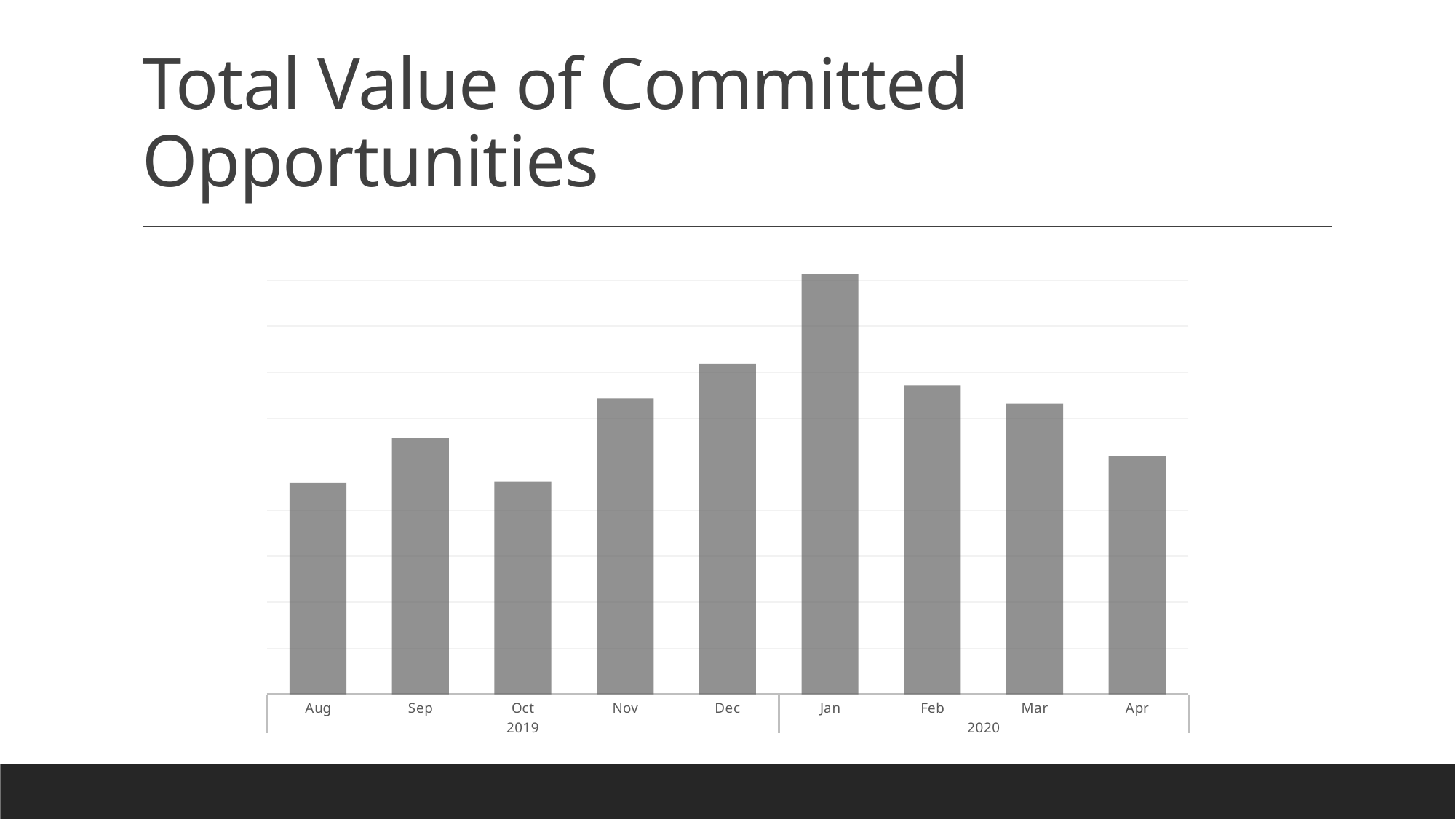
Which is larger, the value for Feb or the value for Apr? Feb Which is larger, the value for Dec or the value for Mar? Dec What kind of chart is shown on the slide? Bar chart Which is larger, the value for Nov or the value for Sep? Nov Which two years are labelled on the x axis of the chart? 2019 and 2020 Which month has the highest bar in the chart? Jan From Jan to Apr, do the values rise or fall? Fall How many bars (months) are plotted in the chart? 9 How many months are grouped under 2020 on the x axis? 4 What is the title of the chart on the slide? Total Value of Committed Opportunities